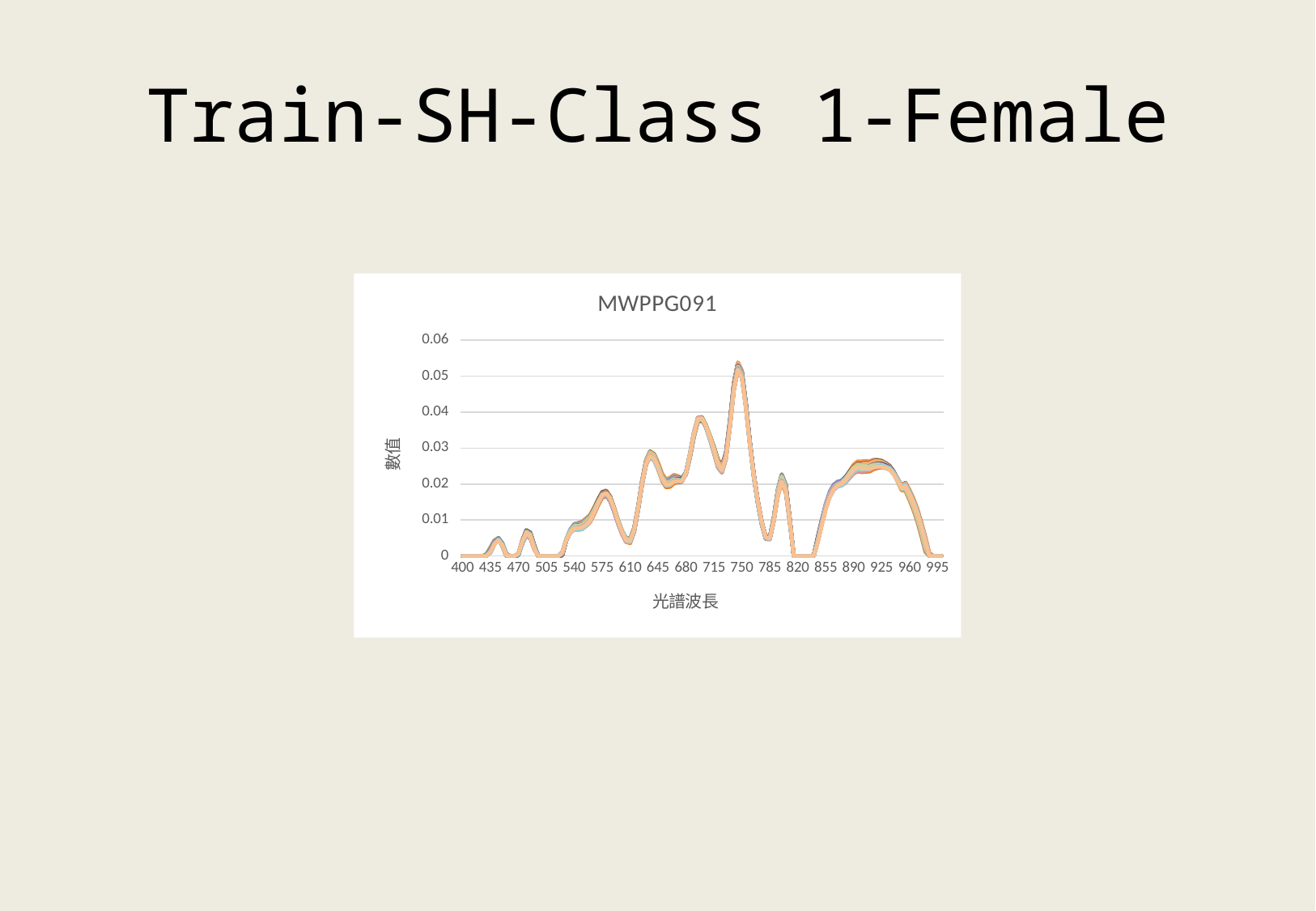
What kind of chart is shown on the slide? line chart Is the value at wavelength 750 greater or less than 0.04? greater What is the title of the chart? MWPPG091 Is the value at wavelength 820 greater or less than 0.01? less Do the values rise or fall between wavelengths 750 and 785? fall Is the value at wavelength 925 greater or less than 0.02? greater What is the label on the x axis of the chart? 光譜波長 Do the values rise or fall between wavelengths 715 and 750? rise How many wavelength tick labels are shown on the x axis? 18